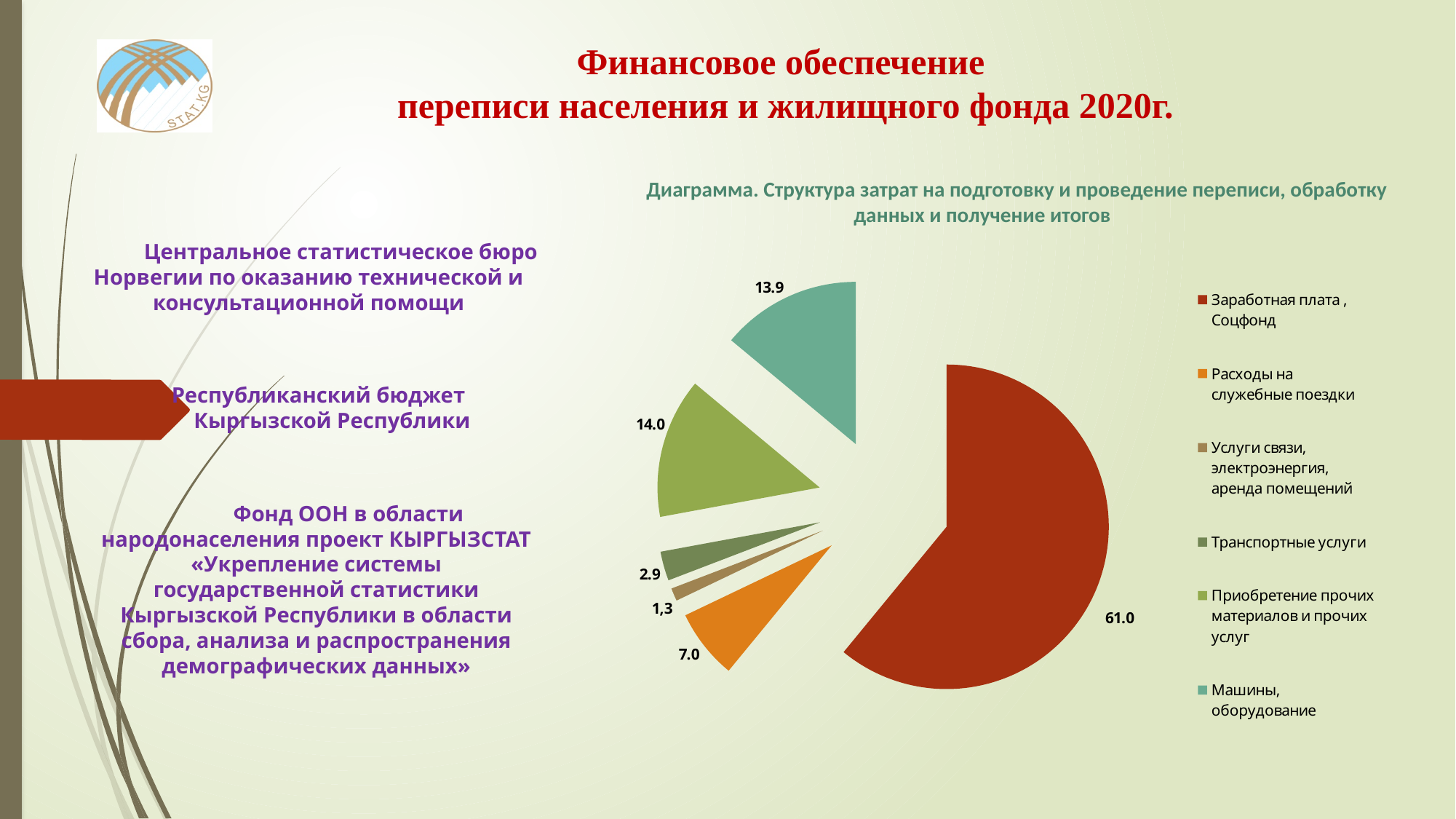
What is the value for Услуги связи, электроэнергия, аренда помещений in the pie chart? 1,3 Which category has the largest slice in the pie chart? Заработная плата, Соцфонд What type of chart is shown on the slide? pie chart Which category has the smallest slice in the pie chart? Услуги связи, электроэнергия, аренда помещений How many slices does the pie chart have? 6 What is the value for Заработная плата, Соцфонд in the pie chart? 61.0 What is the value for Транспортные услуги in the pie chart? 2.9 What is the difference between the values for Заработная плата, Соцфонд and Расходы на служебные поездки? 54.0 What is the value for Машины, оборудование in the pie chart? 13.9 Which is larger: the slice for Приобретение прочих материалов и прочих услуг or the slice for Транспортные услуги? Приобретение прочих материалов и прочих услуг What is the value for Расходы на служебные поездки in the pie chart? 7.0 What colour is the slice for Машины, оборудование? teal